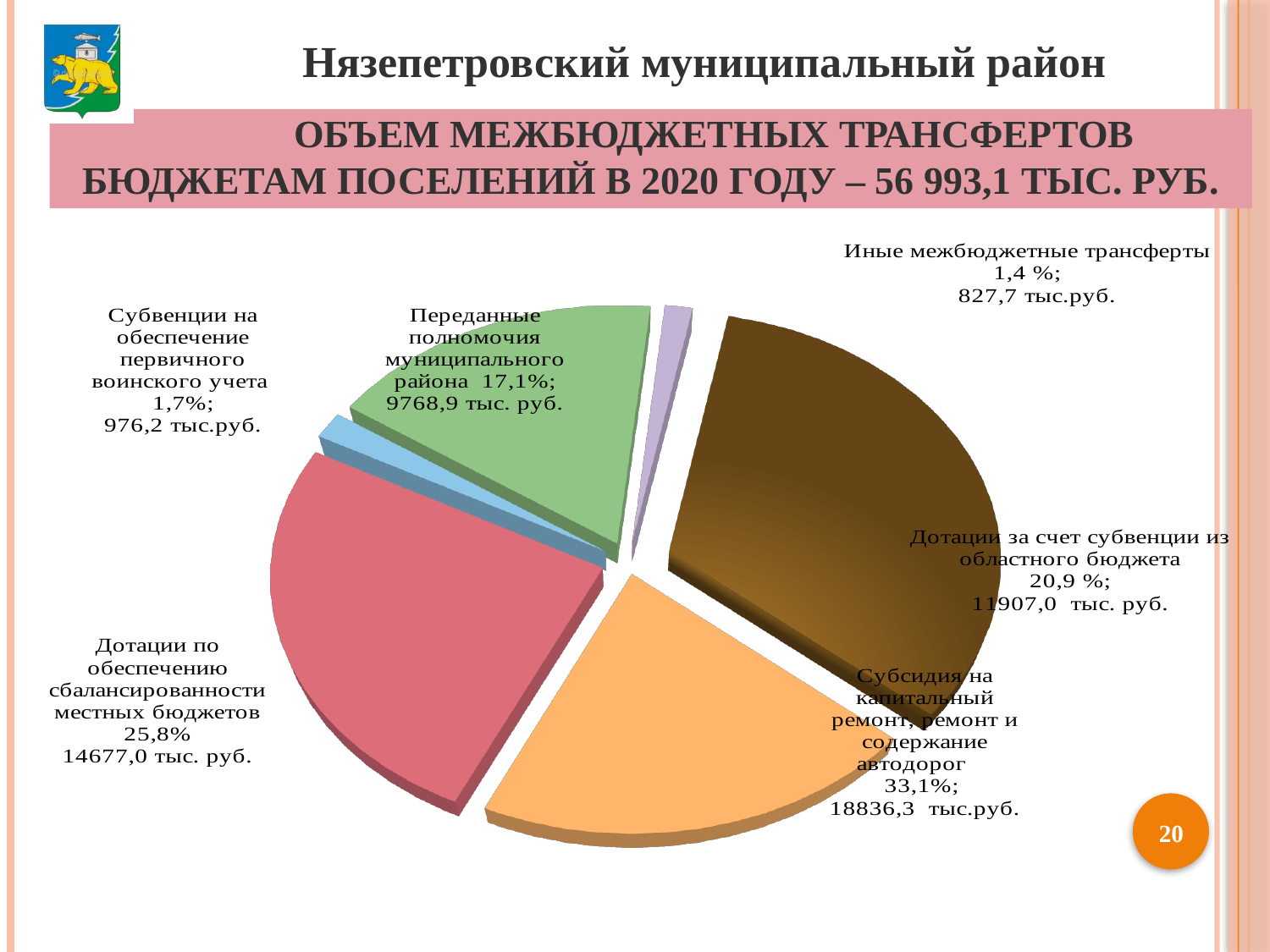
What share of the pie does "Субсидия на капитальный ремонт, ремонт и содержание автодорог" represent? 33,1% What is the value in тыс. руб. for "Переданные полномочия муниципального района"? 9768,9 тыс. руб. Which category has the smallest slice of the pie? Иные межбюджетные трансферты How many slices does the pie chart have? 6 What total amount of intergovernmental transfers for 2020 is stated in the slide title? 56 993,1 тыс. руб. Which category has the largest slice of the pie? Субсидия на капитальный ремонт, ремонт и содержание автодорог What is the value in тыс. руб. for "Иные межбюджетные трансферты"? 827,7 тыс.руб. What type of chart is shown on the slide? pie chart Which is larger: "Субвенции на обеспечение первичного воинского учета" or "Иные межбюджетные трансферты"? Субвенции на обеспечение первичного воинского учета What is the difference in percentage points between "Дотации по обеспечению сбалансированности местных бюджетов" (25,8%) and "Дотации за счет субвенции из областного бюджета" (20,9 %)? 4,9 What is the value in тыс. руб. for "Дотации по обеспечению сбалансированности местных бюджетов"? 14677,0 тыс. руб. What percentage share is shown for "Дотации за счет субвенции из областного бюджета"? 20,9 %